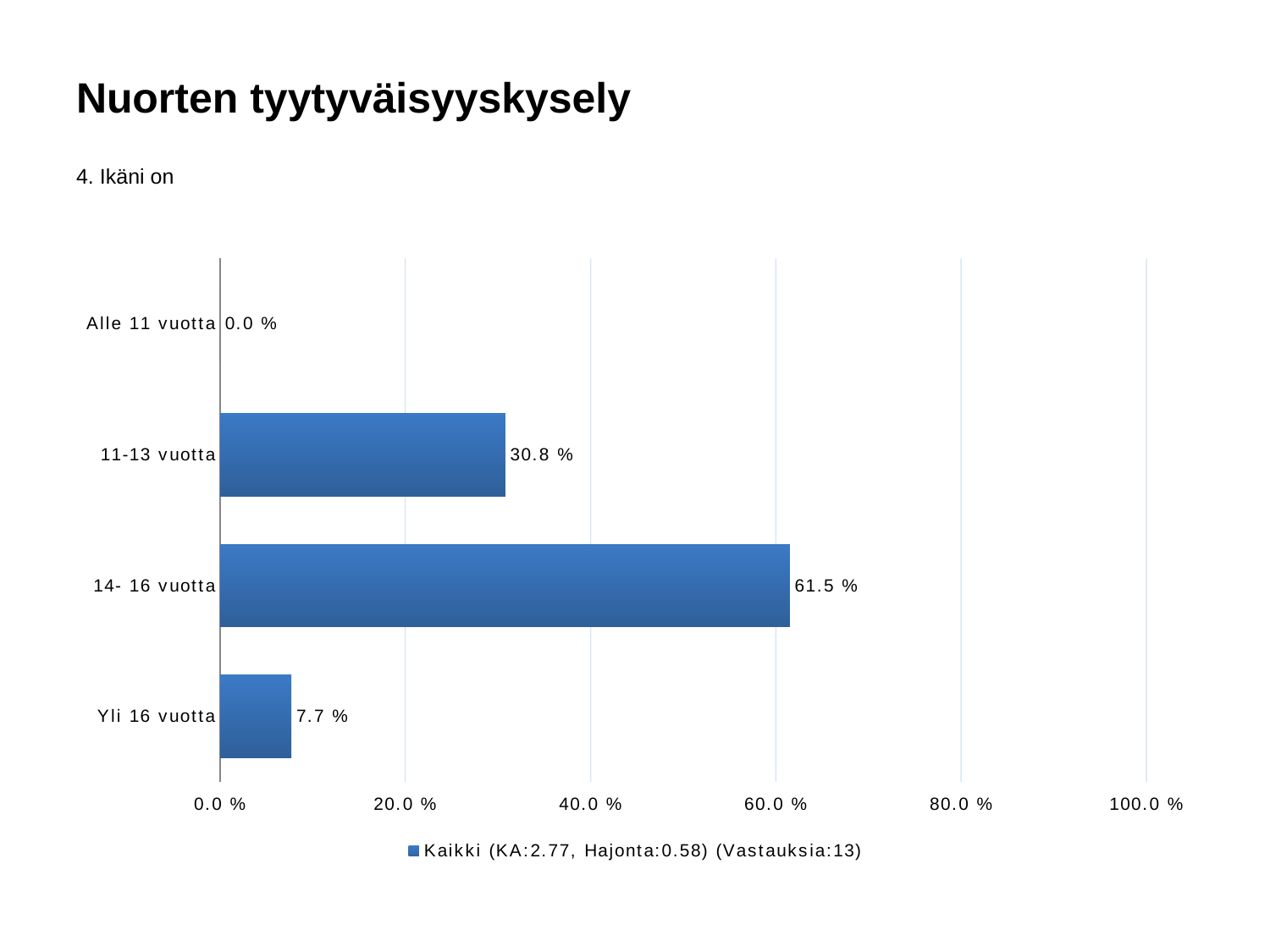
Which category has the lowest value? Alle 11 vuotta What is the value for Yli 16 vuotta? 7.7 % Is the value for 14- 16 vuotta greater or less than 60.0 %? greater Which category has the highest value? 14- 16 vuotta What is the difference between the values for 14- 16 vuotta and 11-13 vuotta? 30.7 % How many categories are shown on the chart? 4 What kind of chart is shown on the slide? bar chart How many responses (Vastauksia) does the legend entry report? 13 What is the value for 11-13 vuotta? 30.8 % Which is larger, the value for 11-13 vuotta or the value for Yli 16 vuotta? 11-13 vuotta What is the value for Alle 11 vuotta? 0.0 % What is the value for 14- 16 vuotta? 61.5 %